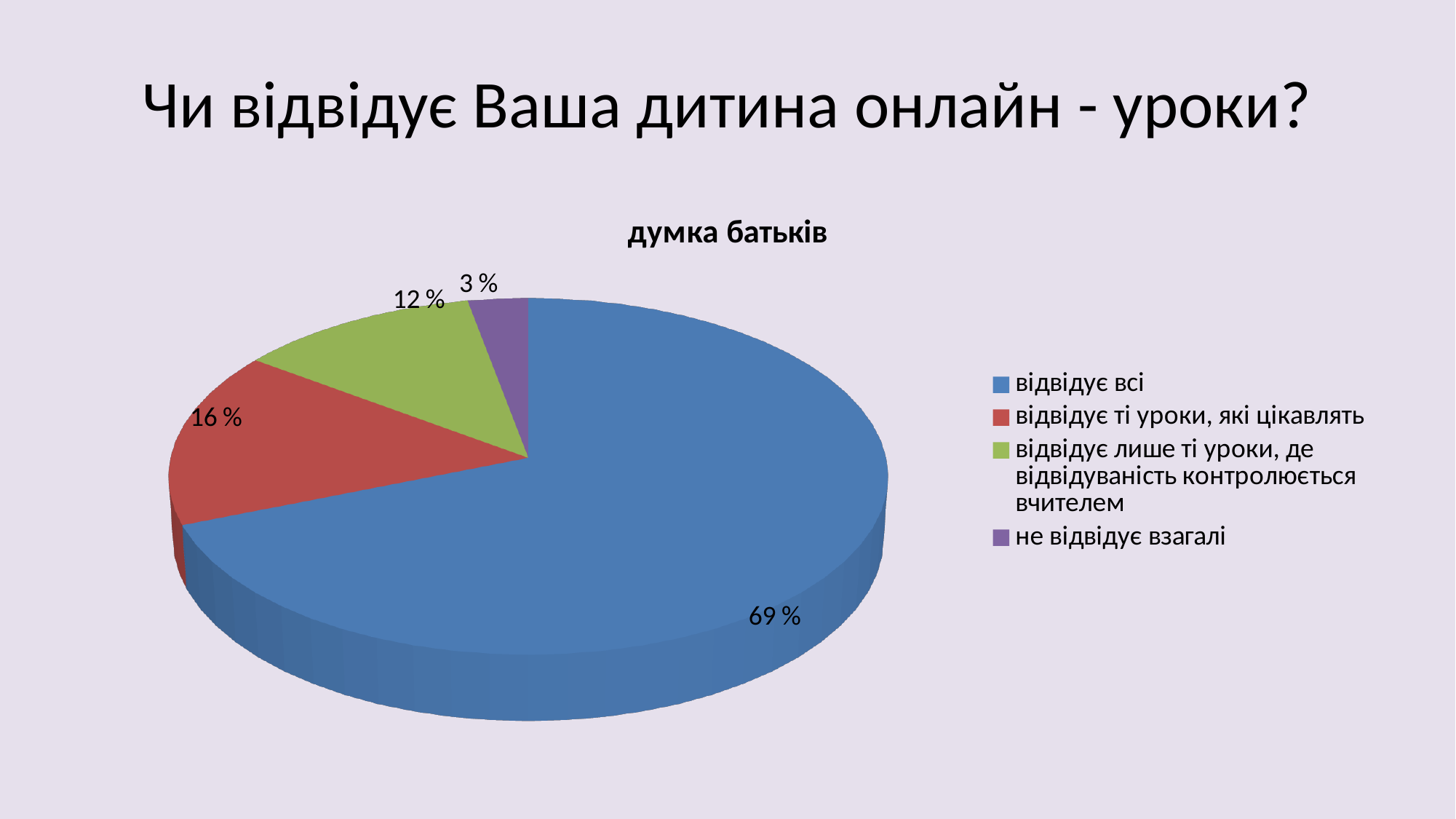
Which category has the largest slice of the pie? відвідує всі What colour is the slice for "не відвідує взагалі"? purple What kind of chart is shown on the slide? pie chart Which is larger: the slice for "відвідує ті уроки, які цікавлять" or the slice for "відвідує лише ті уроки, де відвідуваність контролюється вчителем"? відвідує ті уроки, які цікавлять What is the difference in percentage points between "відвідує всі" and "відвідує ті уроки, які цікавлять"? 53 What share of the pie is labelled "відвідує всі"? 69 % What share of the pie is labelled "не відвідує взагалі"? 3 % What is the chart's title? думка батьків Which category has the smallest slice of the pie? не відвідує взагалі How many categories does the pie chart show? 4 What share of the pie is labelled "відвідує ті уроки, які цікавлять"? 16 % What share of the pie is labelled "відвідує лише ті уроки, де відвідуваність контролюється вчителем"? 12 %